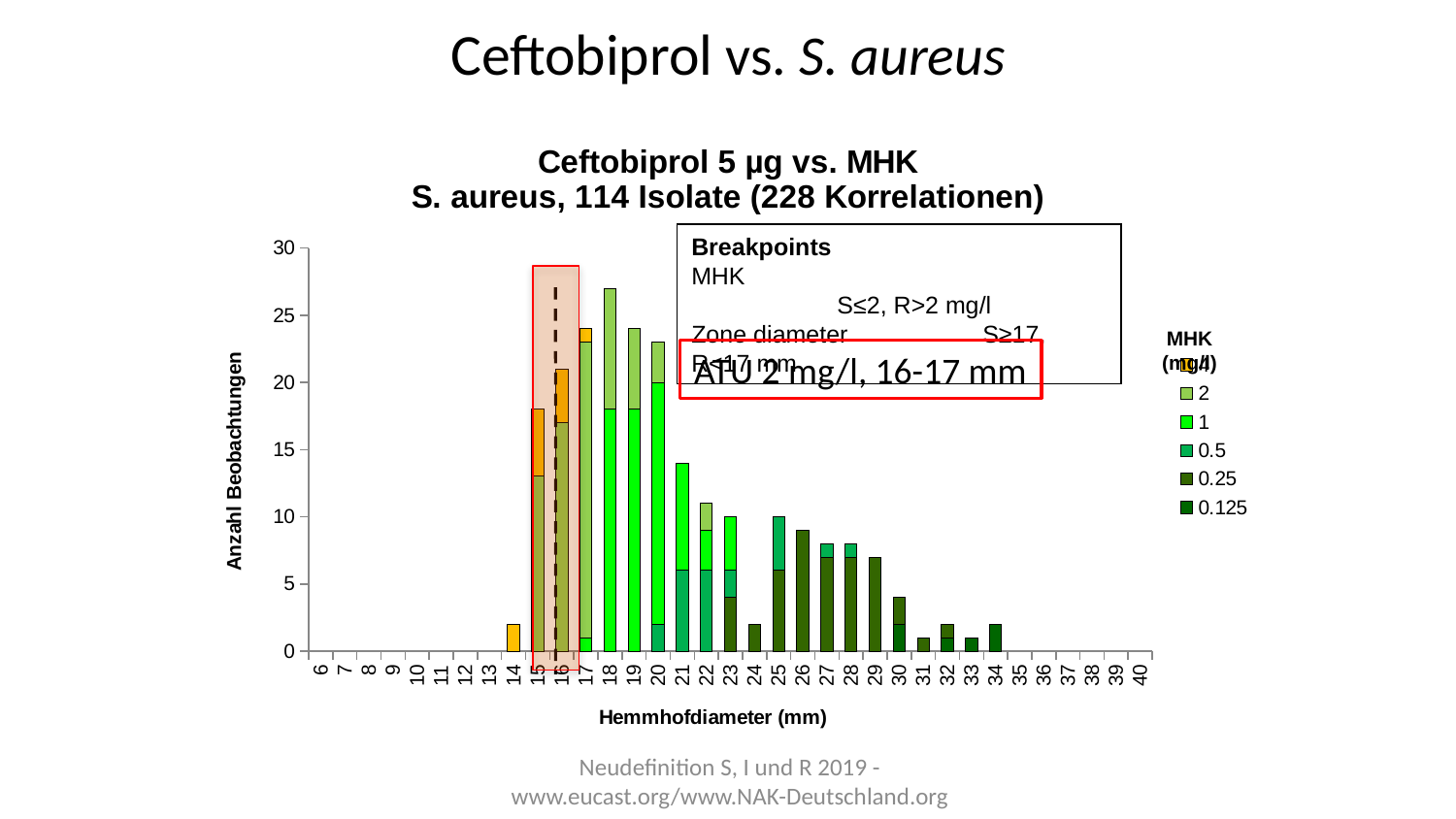
Is the total value for Hemmhofdiameter 21 greater or less than 10? greater What is the title of the chart? Ceftobiprol 5 µg vs. MHK S. aureus, 114 Isolate (228 Korrelationen) Which Hemmhofdiameter has the tallest stacked bar? 18 What is the label of the x axis of the chart? Hemmhofdiameter (mm) Which has the larger total bar, Hemmhofdiameter 18 or Hemmhofdiameter 21? 18 Which has the larger total bar, Hemmhofdiameter 14 or Hemmhofdiameter 30? 30 What kind of chart is shown on the slide? Stacked bar chart Is the total value for Hemmhofdiameter 14 greater or less than 5? less How many MHK values does the legend list? 6 Is the total value for Hemmhofdiameter 18 greater or less than 25? greater Do the bar totals rise or fall as the Hemmhofdiameter increases from 18 mm to 30 mm? fall